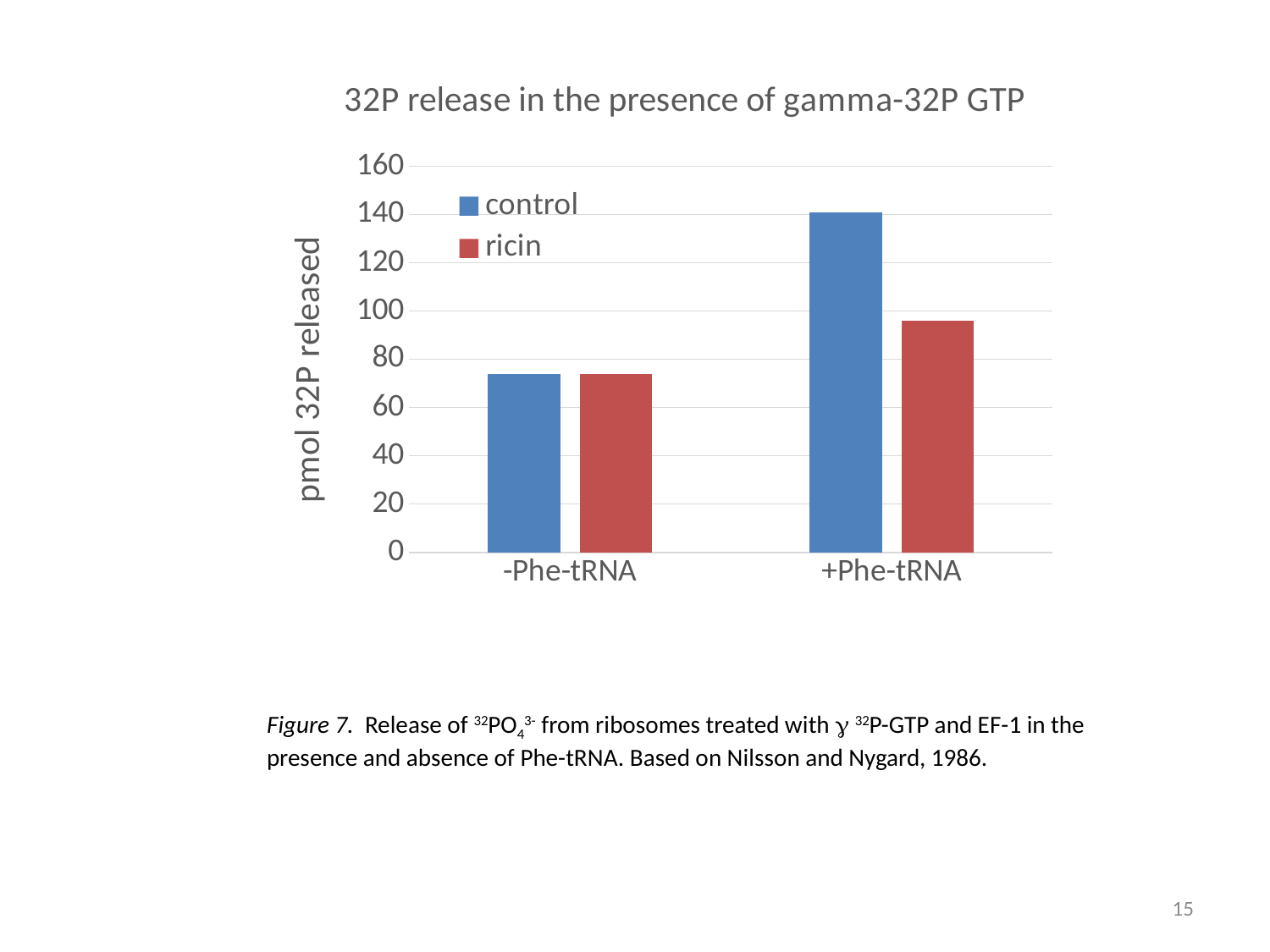
Is the control value for +Phe-tRNA greater or less than 120? greater Is the control value for -Phe-tRNA greater or less than 80? less Is the ricin value for +Phe-tRNA greater or less than 80? greater Does the control value rise or fall from -Phe-tRNA to +Phe-tRNA? rise Which bar is the highest in the chart? control at +Phe-tRNA What is the title of the chart? 32P release in the presence of gamma-32P GTP What kind of chart is shown on the slide? bar chart How many series does the legend list? 2 For +Phe-tRNA, which series has the larger value, control or ricin? control What is the label of the y axis? pmol 32P released How many categories are shown on the x axis? 2